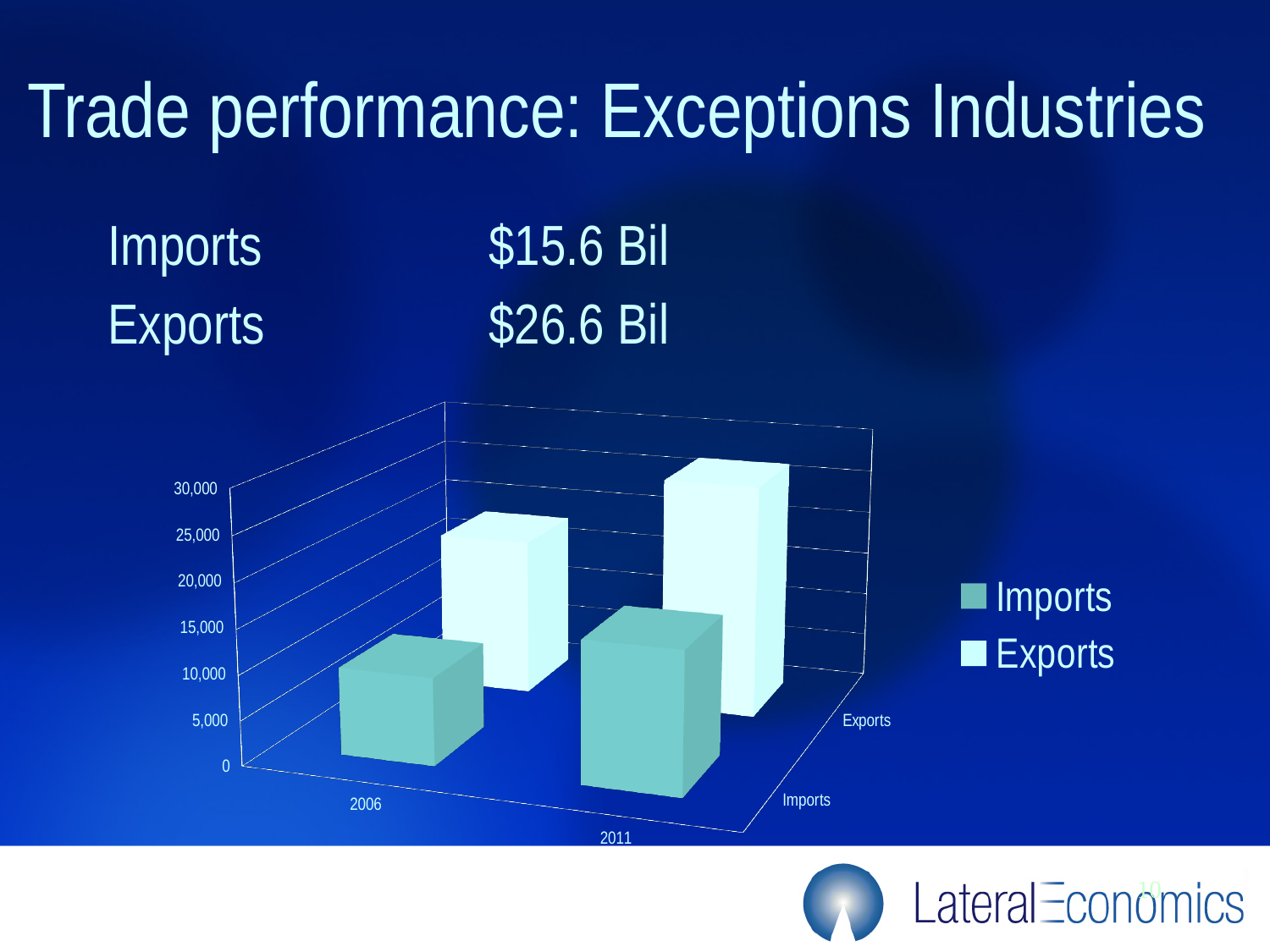
How many series does the chart legend list? 2 Which years are shown as categories on the chart's x axis? 2006 and 2011 Is the value for Exports in 2011 greater or less than 15,000? greater Is the value for Imports in 2006 greater or less than 20,000? less Which series is larger in 2011, Imports or Exports? Exports Do Imports rise or fall from 2006 to 2011? rise Which series is larger in 2006, Imports or Exports? Exports What is the highest tick value shown on the chart's vertical axis? 30,000 What kind of chart is shown on the slide? bar chart How many year categories are plotted on the chart? 2 Which series is shown in the teal/green colour in the legend? Imports Do Exports rise or fall from 2006 to 2011? rise